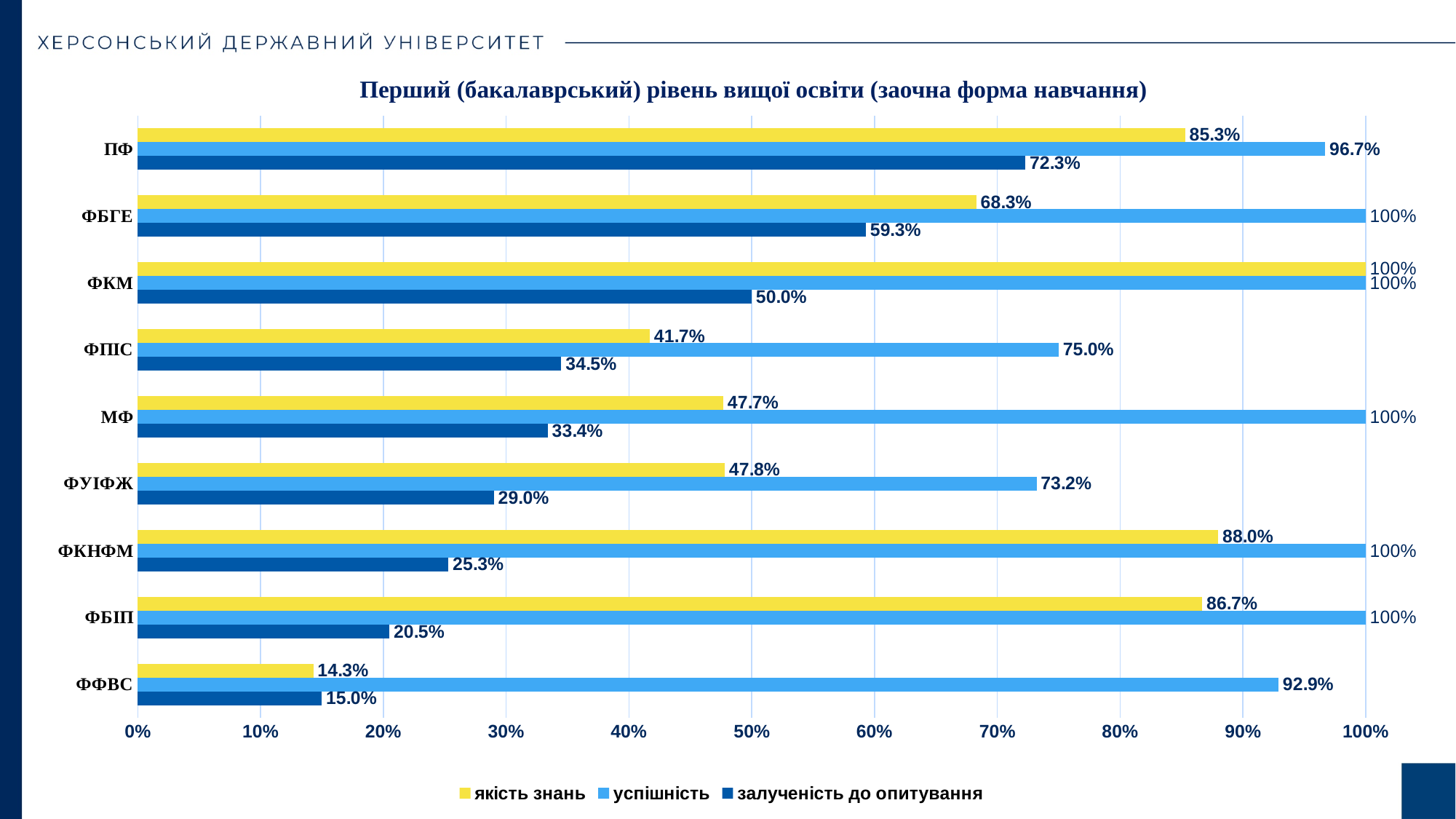
What is the залученість до опитування value for ФКНФМ? 25.3% What is the успішність value for ФФВС? 92.9% What is the якість знань value for ПФ? 85.3% What is the difference between the успішність and якість знань values for ПФ? 11.4 percentage points What is the title of the chart? Перший (бакалаврський) рівень вищої освіти (заочна форма навчання) Which category has the highest залученість до опитування value? ПФ Is the успішність value for ФПІС greater or less than 70%? greater How many series does the legend list? 3 What kind of chart is shown on the slide? Bar chart Which category has the lowest якість знань value? ФФВС Which is larger, the якість знань value for ФКНФМ or for ФБІП? ФКНФМ How many categories (faculties) are shown on the chart? 9